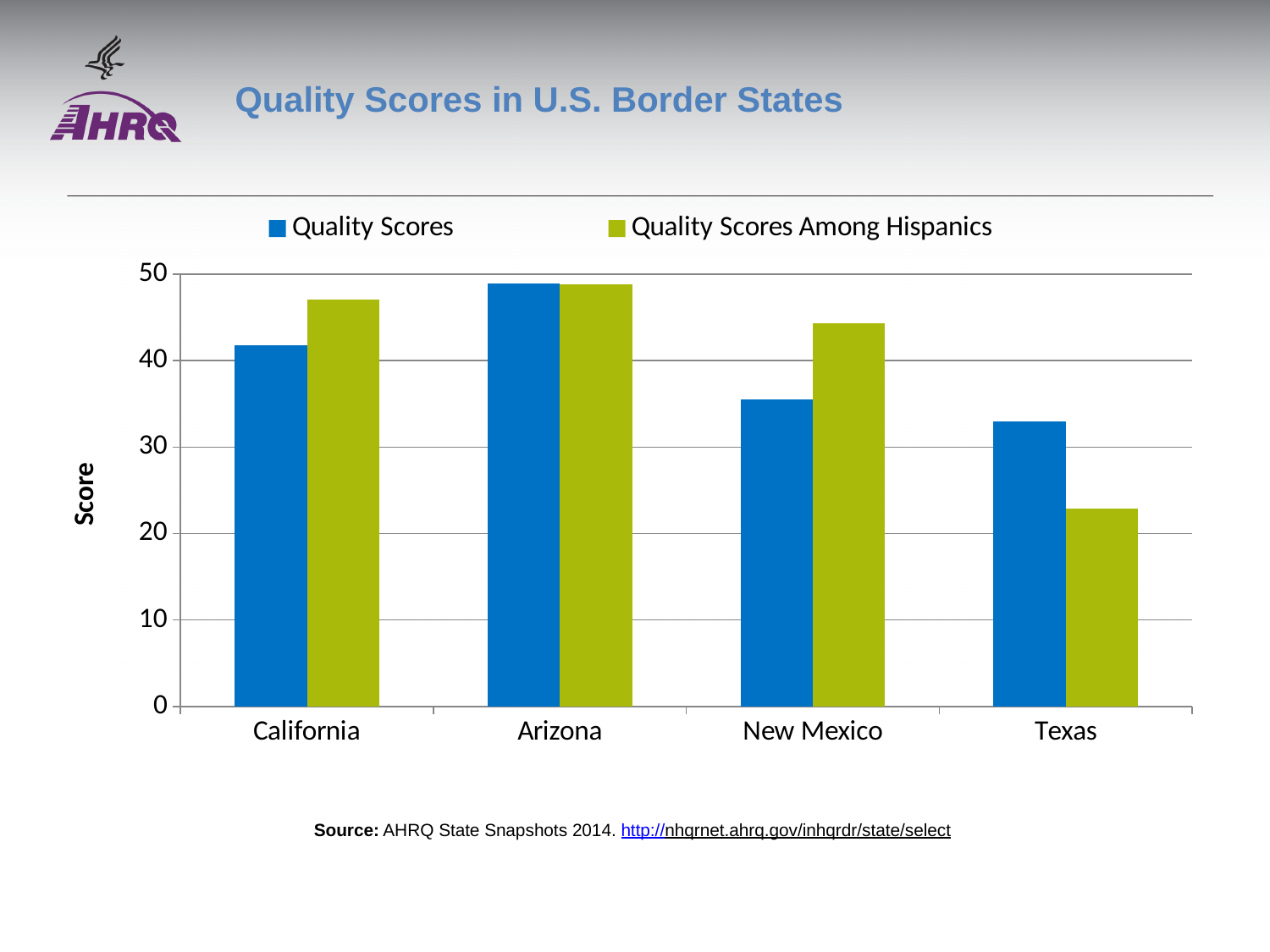
Is the Quality Scores Among Hispanics value for Texas greater or less than 30? less For Texas, which is larger: Quality Scores or Quality Scores Among Hispanics? Quality Scores How many series does the legend list? 2 For California, which is larger: Quality Scores or Quality Scores Among Hispanics? Quality Scores Among Hispanics Which state has the lowest Quality Scores Among Hispanics value? Texas Is the Quality Scores value for New Mexico greater or less than 40? less Which state has the highest Quality Scores value? Arizona What is the title of the chart? Quality Scores in U.S. Border States Is the Quality Scores value for California greater or less than 40? greater How many states are shown on the x axis? 4 What kind of chart is shown on the slide? bar chart Which state has the lowest Quality Scores value? Texas